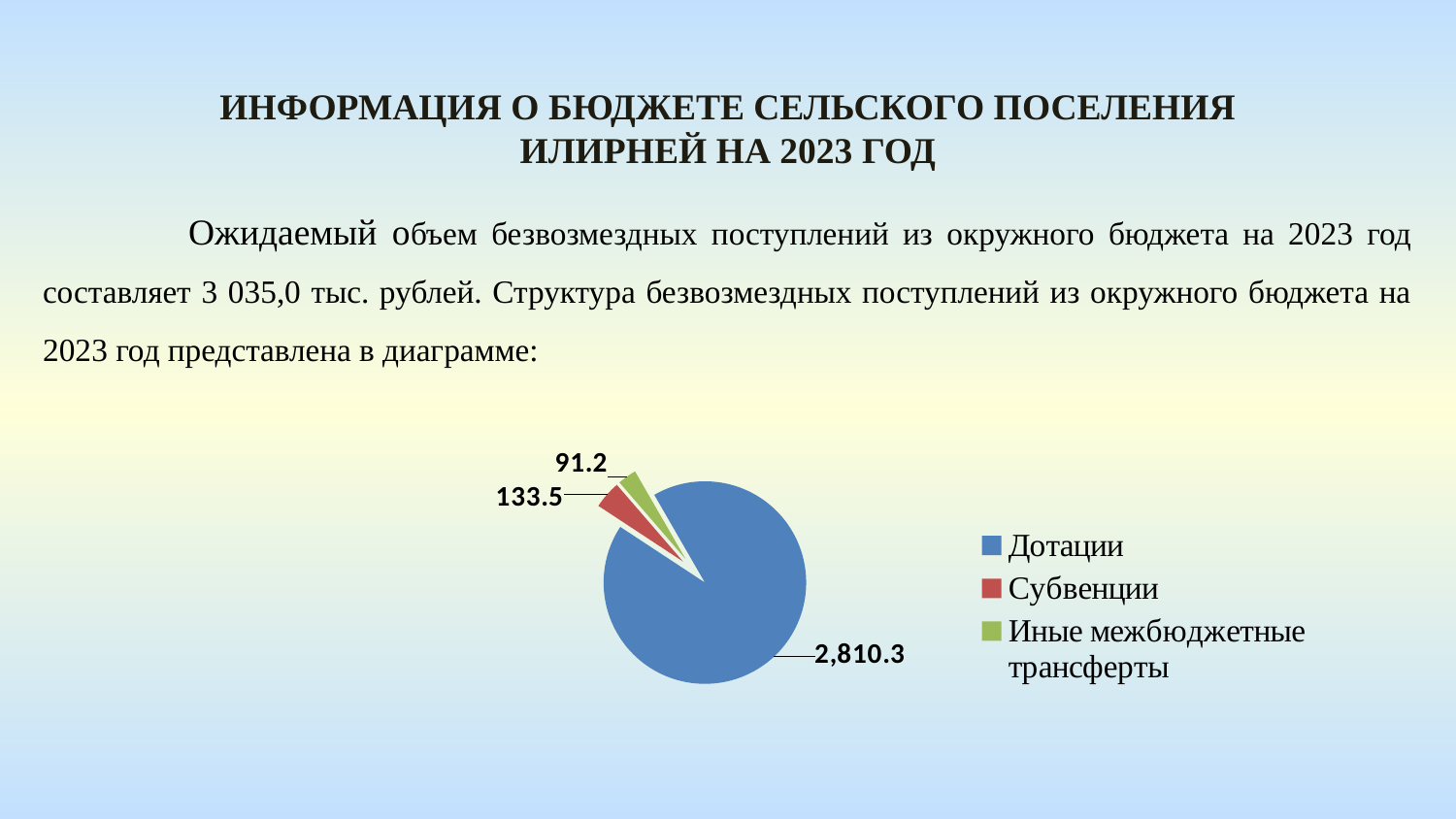
What type of chart is shown on the slide? Pie chart What colour is the Субвенции slice in the pie chart? Red What is the value of the Дотации slice in the pie chart? 2,810.3 What is the difference between the Дотации value and the Субвенции value? 2,676.8 What is the difference between the Субвенции value and the Иные межбюджетные трансферты value? 42.3 Which is larger, Субвенции or Иные межбюджетные трансферты? Субвенции What is the total of all three slices in the pie chart? 3,035.0 What is the value of the Иные межбюджетные трансферты slice in the pie chart? 91.2 What is the value of the Субвенции slice in the pie chart? 133.5 Which category has the largest slice in the pie chart? Дотации Which category has the smallest slice in the pie chart? Иные межбюджетные трансферты How many slices does the pie chart have? 3